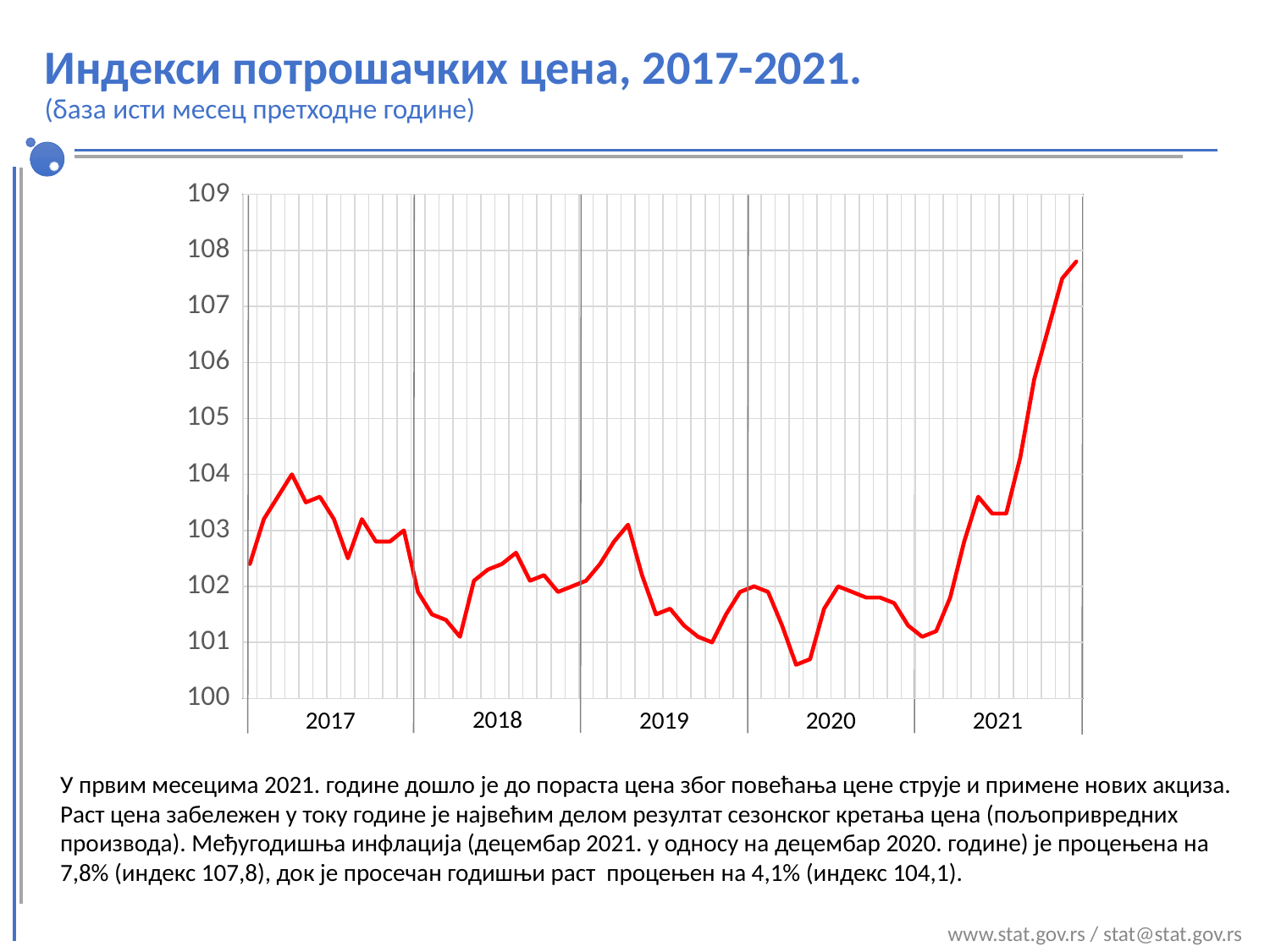
Is the value at the end of 2021 greater or less than 107? greater How many years are labelled along the x axis of the chart? 5 Is the lowest value in 2018 greater or less than 102? less What is the highest value shown on the y axis of the chart? 109 Does the line rise or fall over the course of 2021? rises Which is higher: the peak value in 2017 or the peak value in 2019? 2017 Is the peak value in 2017 greater or less than 103? greater In which year does the line reach its lowest value? 2020 In which year does the line reach its highest value? 2021 How many data series are plotted in the chart? 1 What kind of chart is shown on the slide? line chart